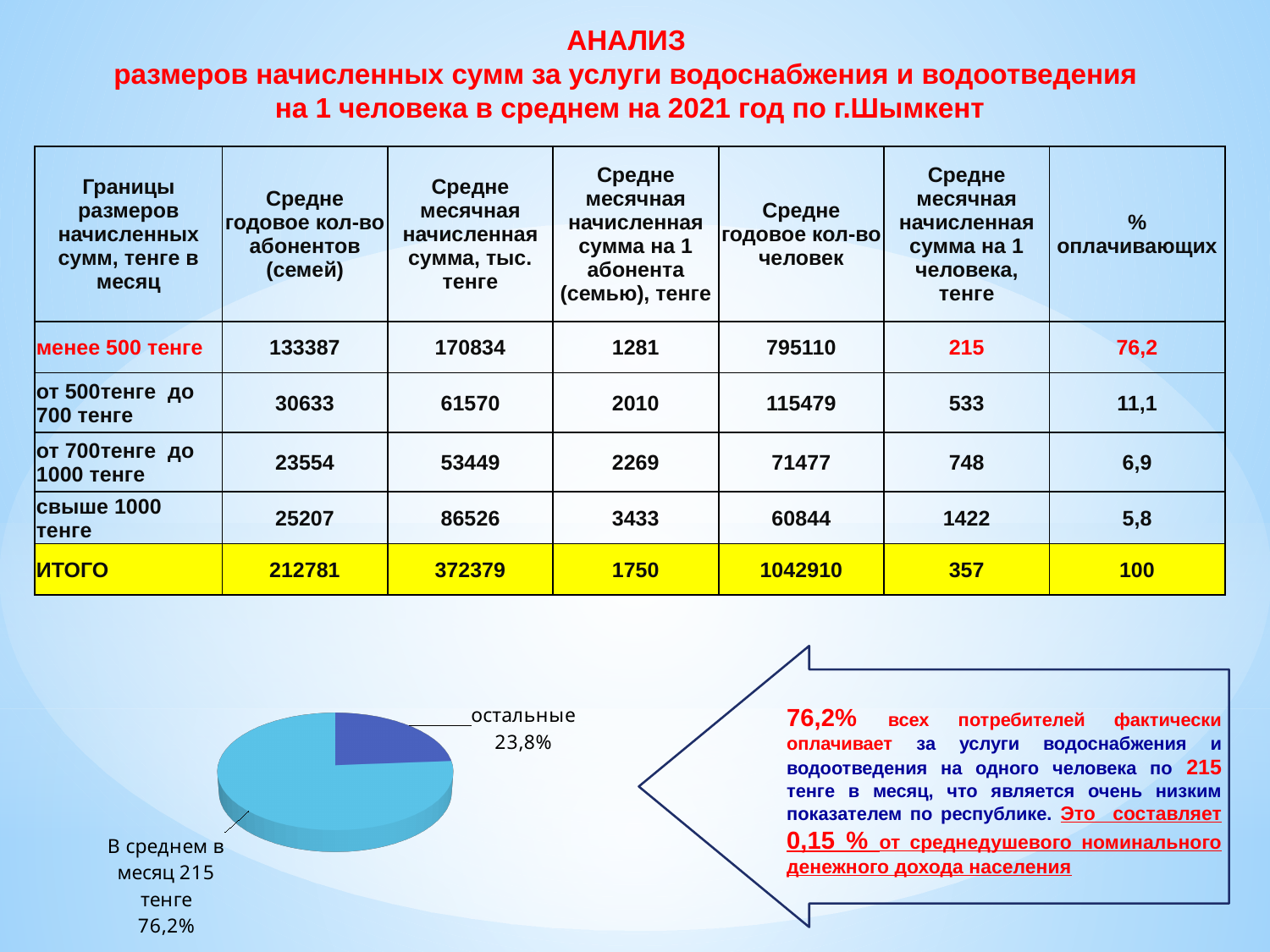
In the pie chart, what is the difference between the "В среднем в месяц 215 тенге" share and the "остальные" share? 52,4% Is the "остальные" slice of the pie chart greater or less than 50%? less Which slice of the pie chart is the largest? В среднем в месяц 215 тенге How many slices does the pie chart have? 2 What share of the pie chart is labelled "остальные"? 23,8% What kind of chart is shown at the bottom left of the slide? pie chart In the pie chart, which is larger: the "остальные" slice or the "В среднем в месяц 215 тенге" slice? В среднем в месяц 215 тенге What do the two slices of the pie chart add up to? 100% What share of the pie chart is labelled "В среднем в месяц 215 тенге"? 76,2% Is the pie chart drawn in 3D or flat? 3D Which slice of the pie chart is the smallest? остальные What colour is the "остальные" slice in the pie chart? dark blue